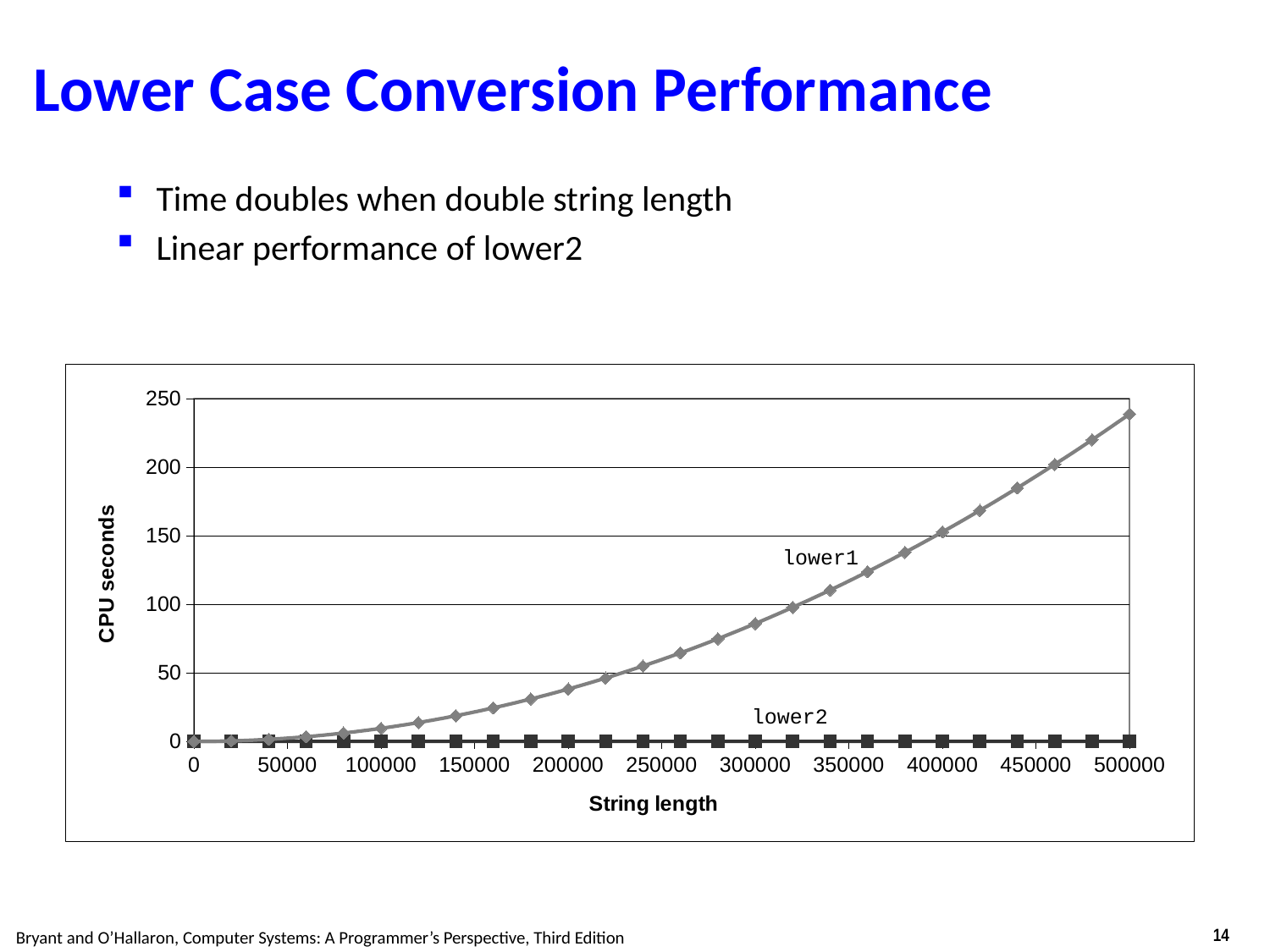
What kind of chart is shown on the slide? line chart At a string length of 500000, which series has the larger value, lower1 or lower2? lower1 Does the lower1 series rise or fall as string length increases? rise Is the value for lower1 at a string length of 300000 greater or less than 100? less What is the label of the y axis of the chart? CPU seconds Is the value for lower1 at a string length of 200000 greater or less than 50? less Is the value for lower2 at a string length of 500000 greater or less than 50? less Which series reaches the highest CPU seconds value on the chart? lower1 How many data series are plotted on the chart? 2 What is the label of the x axis of the chart? String length